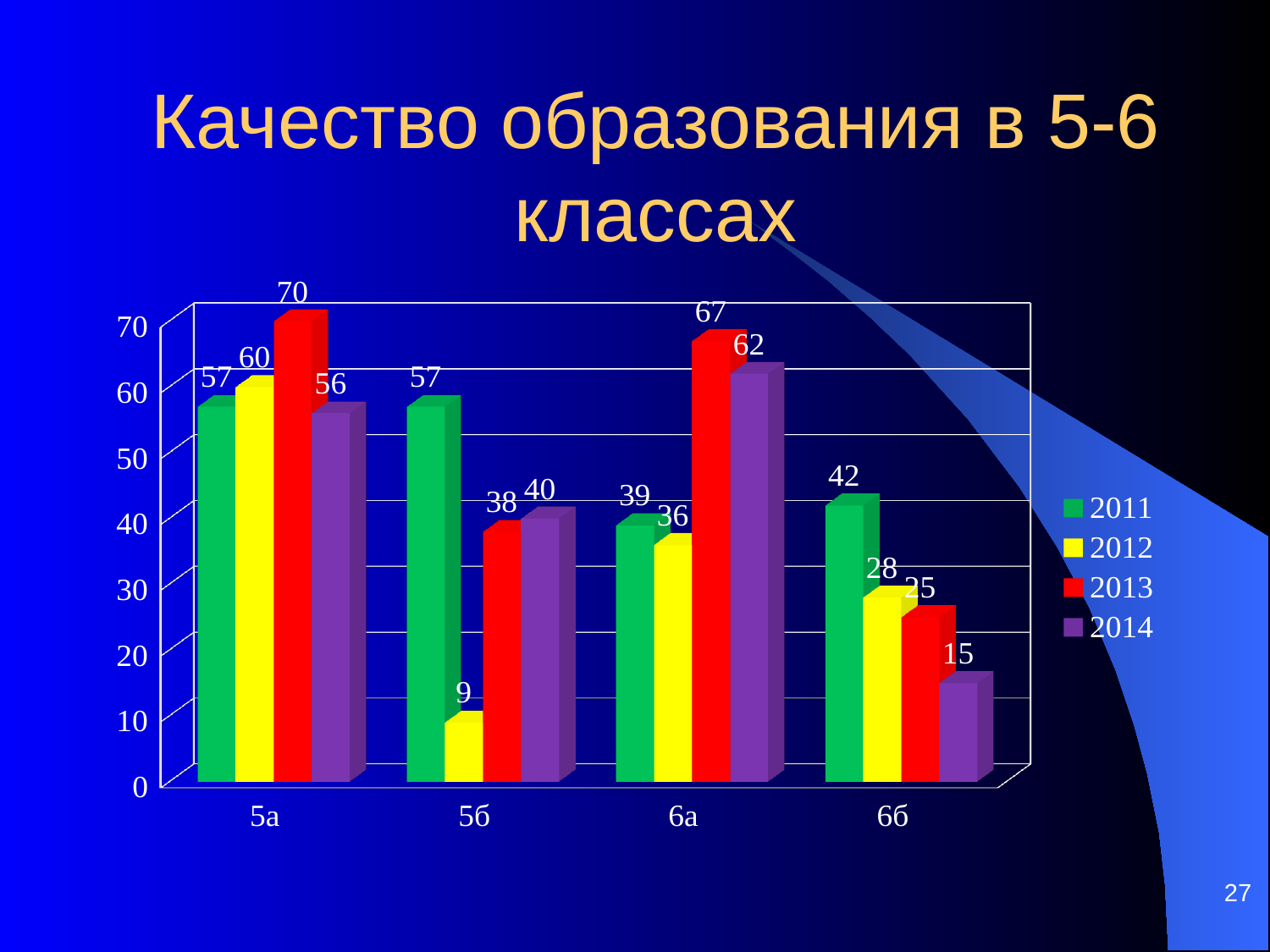
Which class has the lowest value in 2014? 6б How many classes are shown on the x axis? 4 What is the value for 6б in 2014? 15 Which class has the highest value in 2011? 5а and 5б (both 57) What is the value for 5а in 2013? 70 What is the value for 6а in 2014? 62 How many series does the legend list? 4 What kind of chart is shown on the slide? Bar chart What is the difference between the 2013 and 2014 values for 6а? 5 Which colour represents 2013 in the legend? Red Which is larger for 6б: the 2011 value or the 2012 value? 2011 What is the value for 5б in 2012? 9